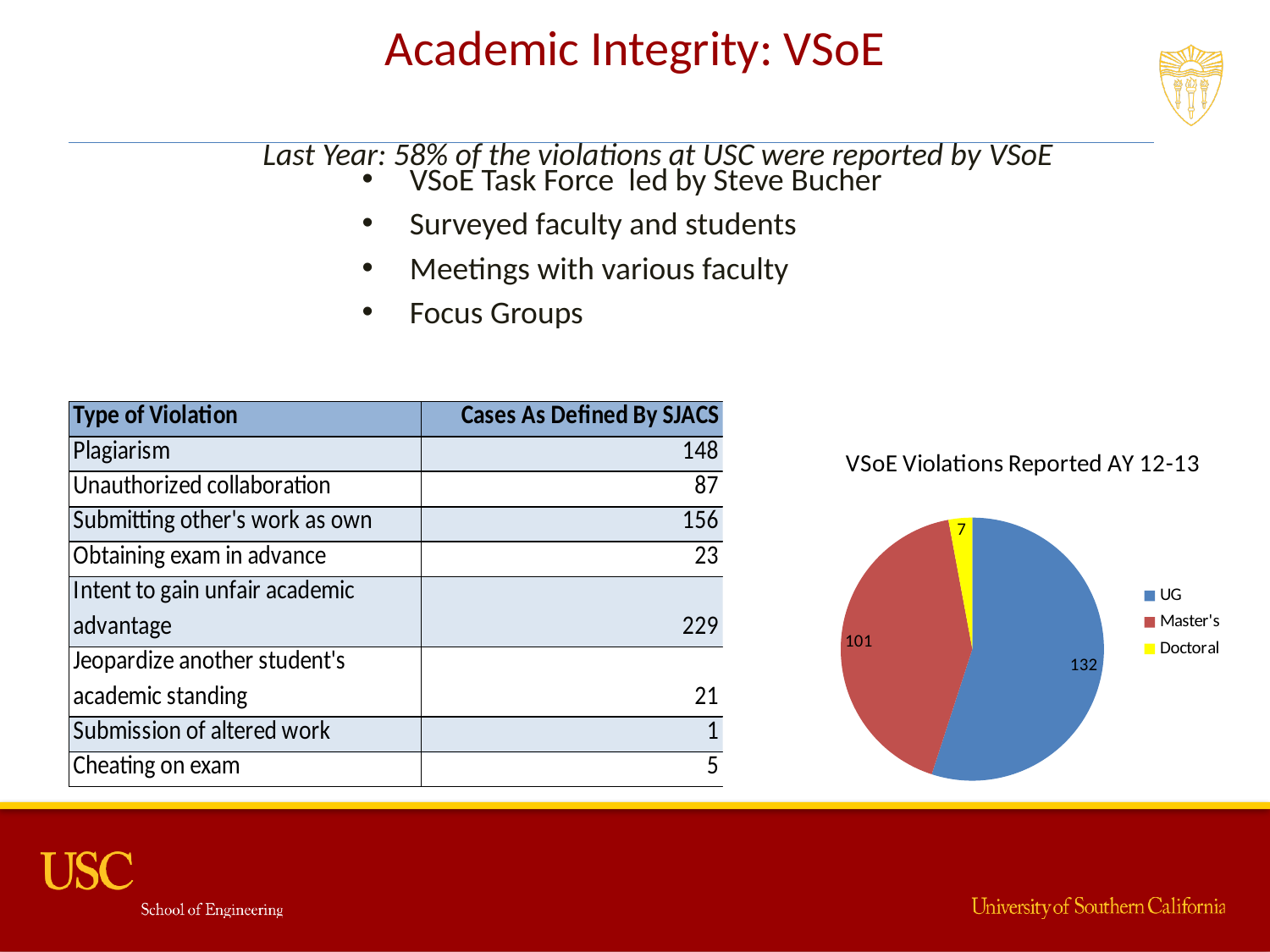
Which category has the largest slice in the pie chart? UG Which is larger in the pie chart, Master's or Doctoral? Master's What is the difference between the UG and Master's values in the pie chart? 31 Which category has the smallest slice in the pie chart? Doctoral How many categories does the pie chart show? 3 How many violations were reported for Master's in the pie chart? 101 What is the title of the chart on the slide? VSoE Violations Reported AY 12-13 How many violations were reported for Doctoral in the pie chart? 7 How many violations were reported for UG in the pie chart? 132 What is the total of all slices in the pie chart? 240 What share of the pie chart does the UG slice represent? 55% What type of chart is shown on the slide? pie chart